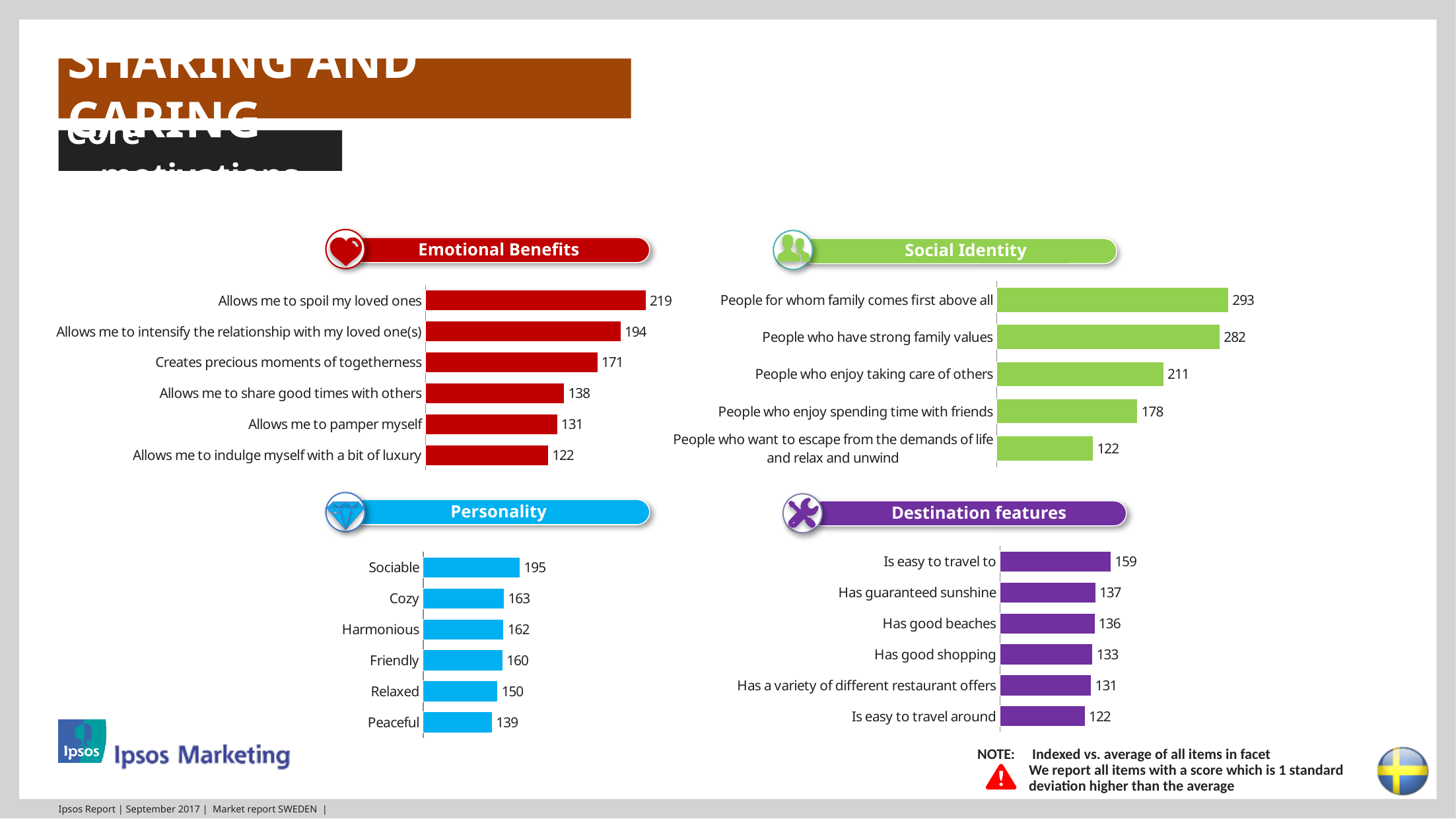
In the Emotional Benefits chart, which is larger: "Creates precious moments of togetherness" or "Allows me to share good times with others"? Creates precious moments of togetherness In the Emotional Benefits chart, what is the value for "Allows me to spoil my loved ones"? 219 In the Social Identity chart, which category has the highest value? People for whom family comes first above all How many categories are shown in the Social Identity chart? 5 In the Social Identity chart, what is the difference between "People who have strong family values" and "People who enjoy taking care of others"? 71 How many categories are shown in the Personality chart? 6 In the Destination features chart, what is the difference between "Is easy to travel to" and "Is easy to travel around"? 37 In the Personality chart, what is the value for "Relaxed"? 150 In the Destination features chart, what is the value for "Has good beaches"? 136 What type of chart is the Destination features chart? Bar chart What colour are the bars in the Social Identity chart? Green In the Personality chart, which category has the lowest value? Peaceful